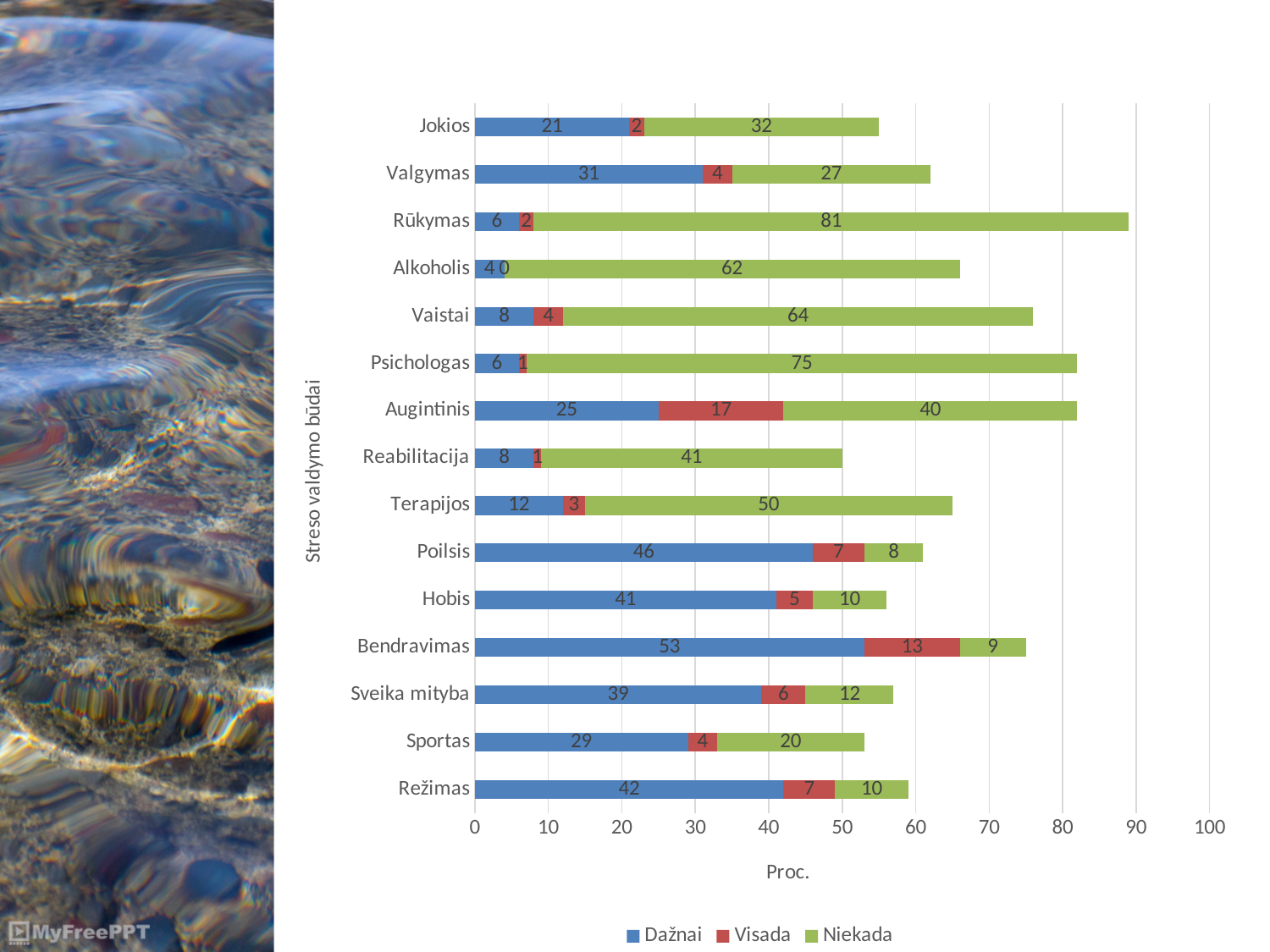
What is the Niekada value for Rūkymas? 81 Which category has the lowest Niekada value? Poilsis How many series does the legend list? 3 What is the total of the stacked bar for Sportas? 53 What is the difference between the Niekada values for Psichologas and Vaistai? 11 What type of chart is shown on the slide? Stacked bar chart How many categories are shown on the y axis? 15 Which category has the highest Dažnai value? Bendravimas What is the Dažnai value for Bendravimas? 53 Which is larger, the Dažnai value for Poilsis or the Dažnai value for Hobis? Poilsis What is the Visada value for Augintinis? 17 What is the total of the stacked bar for Augintinis? 82